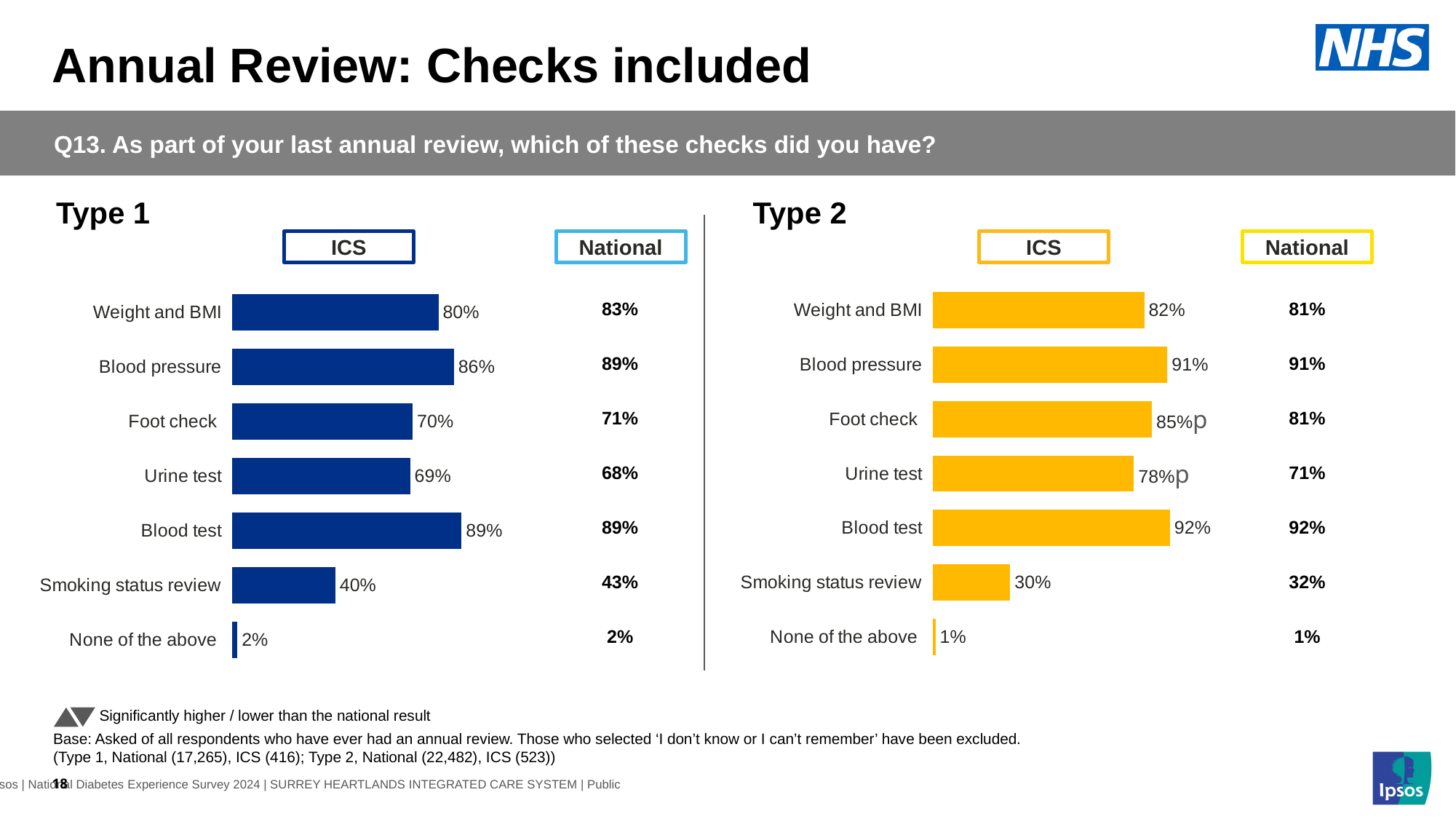
In the Type 1 chart, what is the ICS value for Blood pressure? 86% In the Type 2 chart, what is the National value for Urine test? 71% What colour are the bars in the Type 2 chart? Yellow In the Type 1 chart, what is the difference between the ICS values for Blood pressure and Foot check? 16 percentage points In the Type 1 chart, is the ICS value for Weight and BMI larger or smaller than the National value? smaller How many checks are listed in the Type 2 chart? 7 In the Type 2 chart, what is the ICS value for Foot check? 85% What type of chart is used for the Type 1 ICS results? Bar chart In the Type 2 chart, what is the difference between the ICS and National values for Urine test? 7 percentage points In the Type 2 chart, which check has the lowest ICS value? None of the above In the Type 1 chart, which check has the highest ICS value? Blood test In the Type 1 chart, what is the National value for Smoking status review? 43%